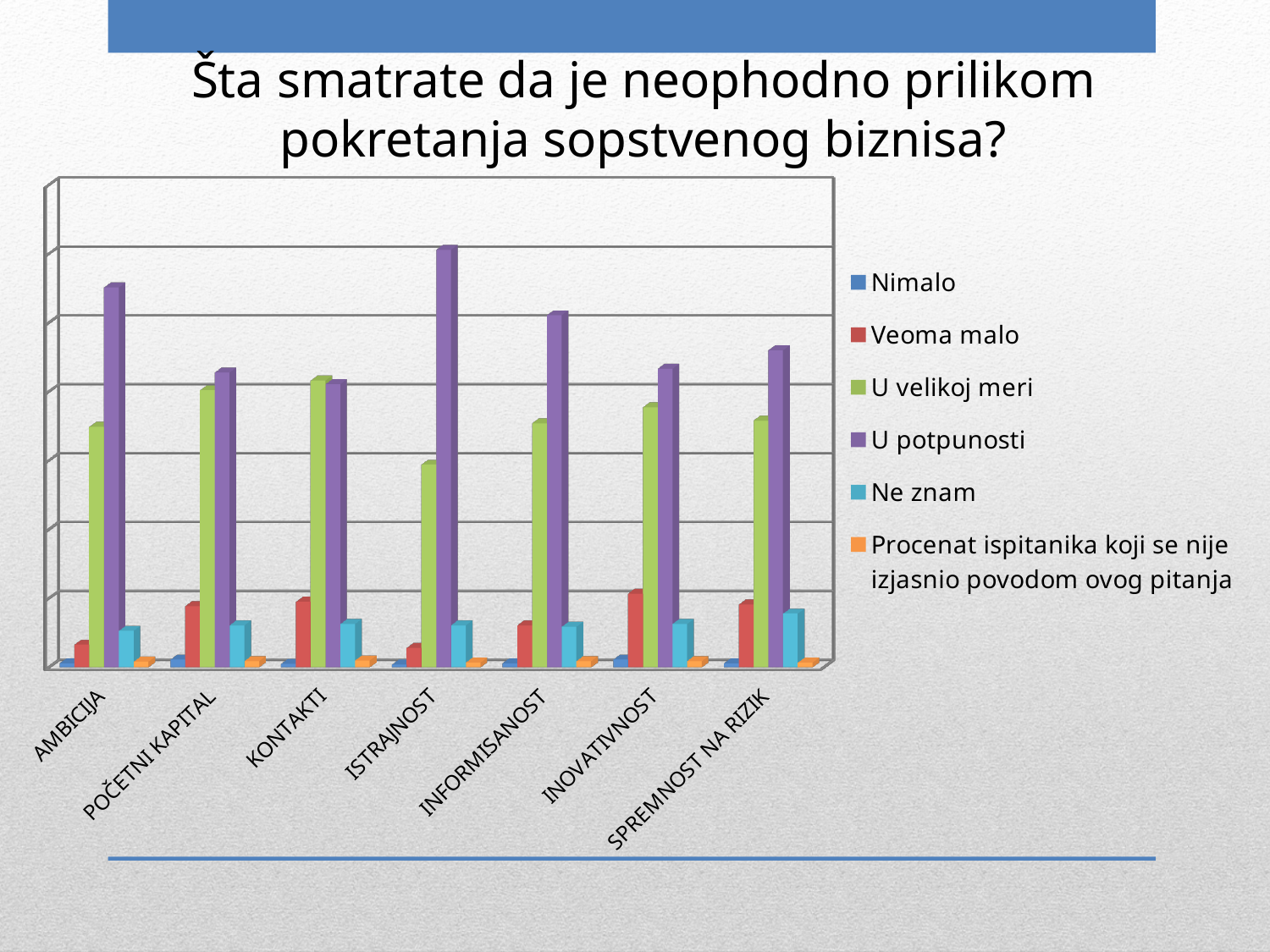
Which category has the lowest bar for the 'U velikoj meri' series? ISTRAJNOST Which category contains the tallest bar in the whole chart? ISTRAJNOST How many categories are shown along the x axis of the chart? 7 For AMBICIJA, which is larger: 'Ne znam' or 'Veoma malo'? Ne znam Which colour represents the 'U potpunosti' series in the legend? Purple Which category has the highest bar for the 'U potpunosti' series? ISTRAJNOST How many series does the chart's legend list? 6 For INOVATIVNOST, which is larger: 'Veoma malo' or 'Ne znam'? Veoma malo What is the title of the slide containing the chart? Šta smatrate da je neophodno prilikom pokretanja sopstvenog biznisa? What kind of chart is shown on the slide? Bar chart For ISTRAJNOST, which is larger: 'U potpunosti' or 'U velikoj meri'? U potpunosti